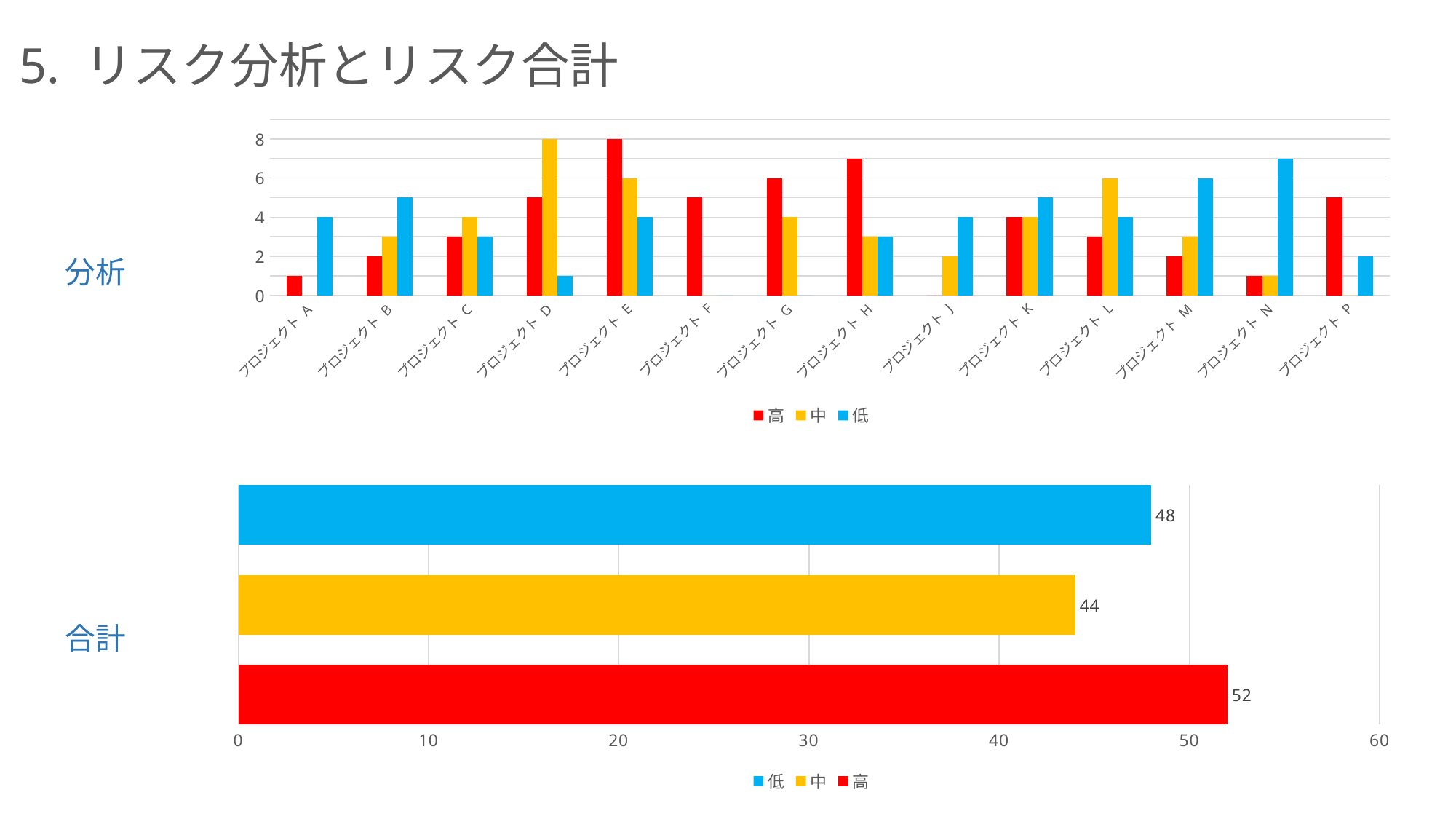
In the top chart (分析), how many projects are shown on the x axis? 14 In the top chart (分析), how many series does the legend list? 3 In the top chart (分析), is the value of 高 for プロジェクト H greater or less than 6? greater In the bottom chart (合計), what is the value for 高? 52 In the bottom chart (合計), which is larger, the value for 低 or the value for 中? 低 In the bottom chart (合計), what is the value for 中? 44 In the bottom chart (合計), which category has the highest value? 高 In the bottom chart (合計), which category has the lowest value? 中 In the top chart (分析), what is the value of 中 for プロジェクト D? 8 In the top chart (分析), what is the value of 低 for プロジェクト A? 4 In the bottom chart (合計), what is the difference between the values for 高 and 中? 8 What kind of chart is the bottom chart (合計)? bar chart